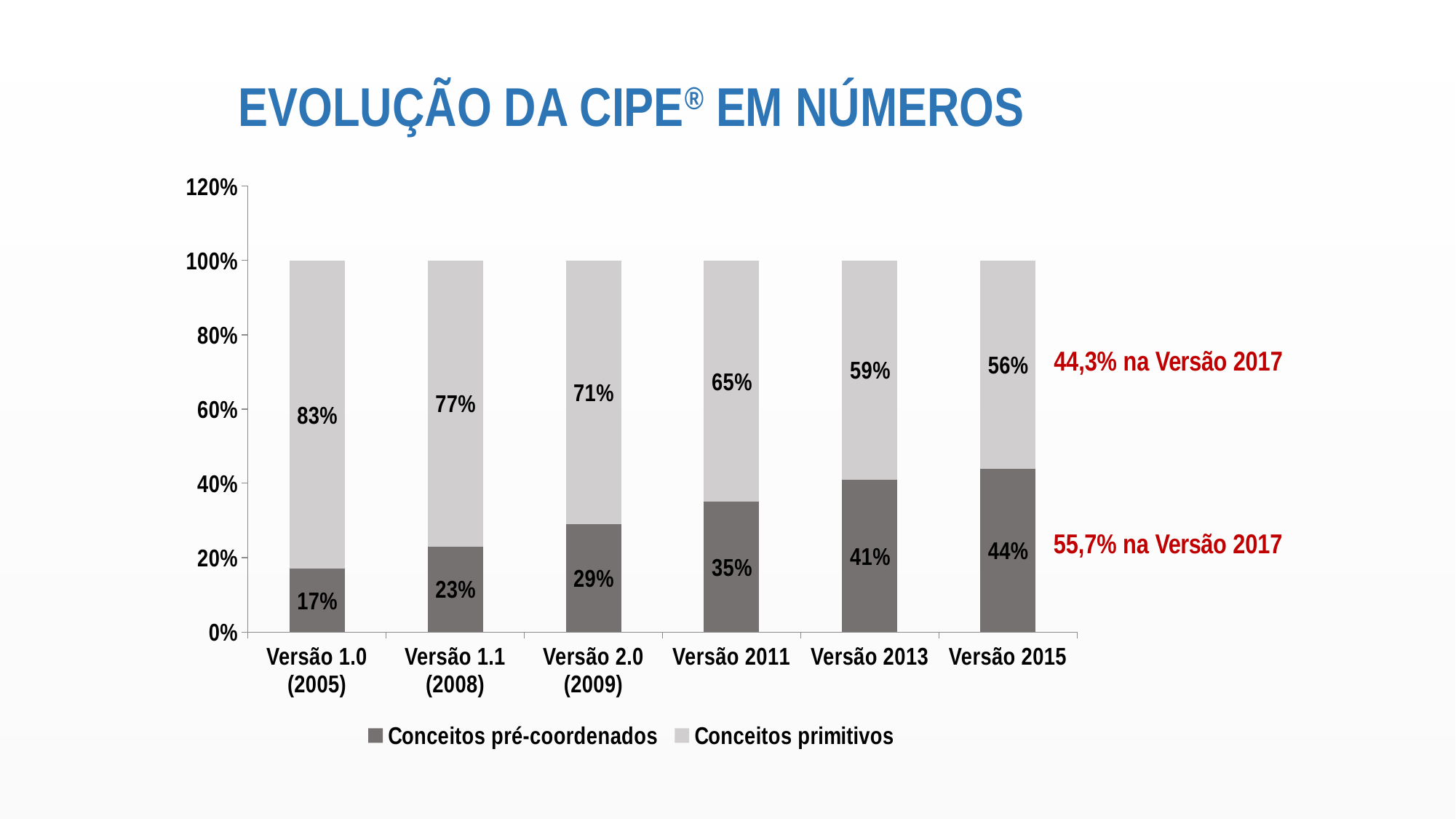
What kind of chart is shown on the slide? Stacked bar chart What is the total of the stacked bar for Versão 2013? 100% How many versions are shown on the x axis? 6 Which version has the highest value for Conceitos pré-coordenados? Versão 2015 What is the difference between the Conceitos primitivos values for Versão 1.0 (2005) and Versão 2015? 27% Which is larger: Conceitos pré-coordenados in Versão 2013 or in Versão 1.1 (2008)? Versão 2013 How many series does the legend list? 2 What is the value for Conceitos pré-coordenados in Versão 1.0 (2005)? 17% Do the values for Conceitos pré-coordenados rise or fall from Versão 1.0 (2005) to Versão 2015? Rise What is the value for Conceitos primitivos in Versão 2.0 (2009)? 71% What is the value for Conceitos primitivos in Versão 2011? 65% Which version has the lowest value for Conceitos primitivos? Versão 2015